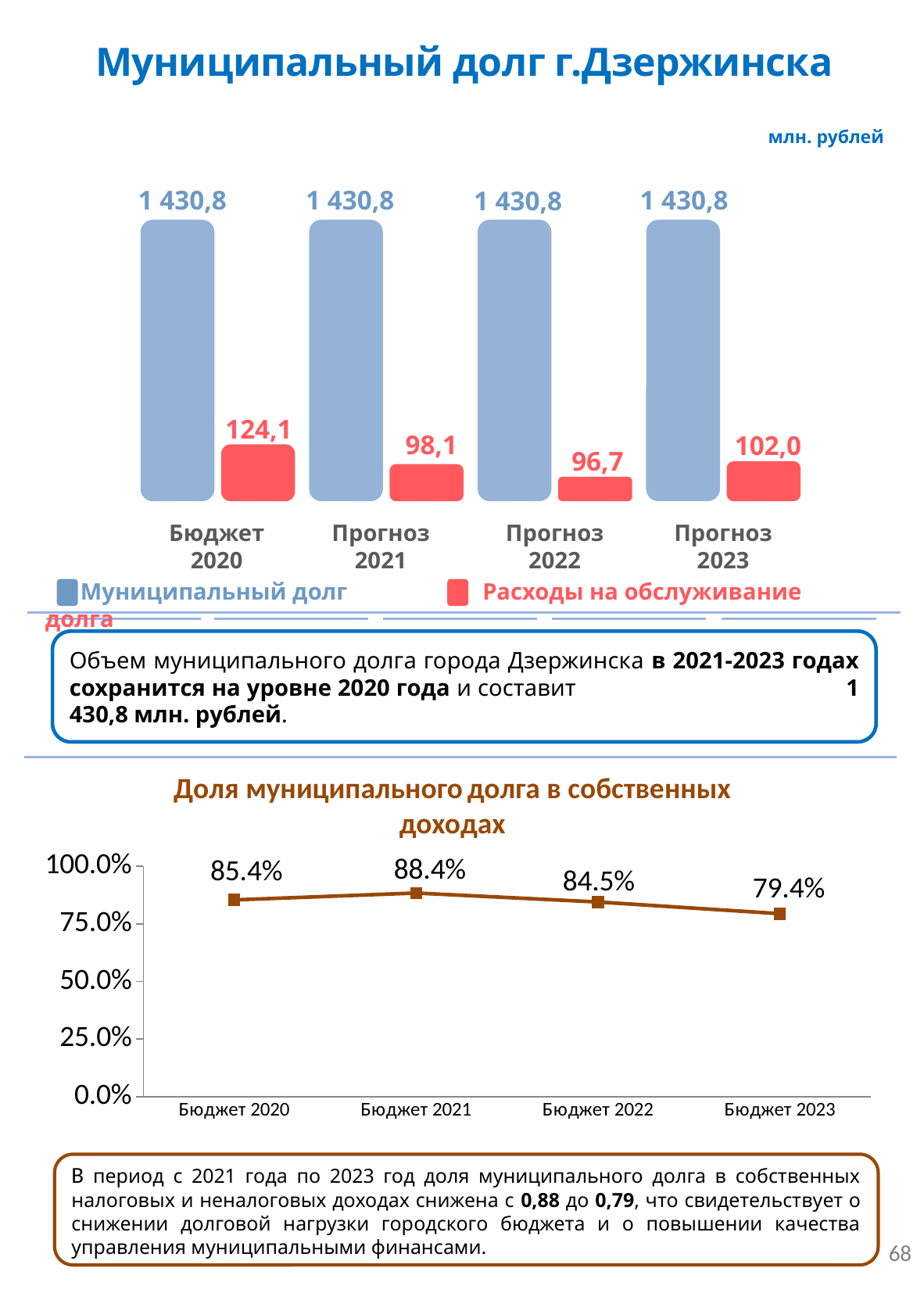
On the top bar chart, what is the value of Расходы на обслуживание долга for Бюджет 2020? 124,1 On the chart 'Доля муниципального долга в собственных доходах', is the value for Бюджет 2023 greater or less than 75.0%? greater On the top bar chart, in which year is Расходы на обслуживание долга lowest? Прогноз 2022 On the chart 'Доля муниципального долга в собственных доходах', which year has the lowest value? Бюджет 2023 On the top bar chart, what is the difference between Расходы на обслуживание долга in Бюджет 2020 and Прогноз 2021? 26,0 On the top bar chart, what unit is shown for the values? млн. рублей What type of chart is the chart titled 'Доля муниципального долга в собственных доходах'? line chart On the top bar chart, what is the value of Муниципальный долг for Прогноз 2023? 1 430,8 On the top bar chart, how many series does the legend list? 2 On the top bar chart, in which year is Расходы на обслуживание долга highest? Бюджет 2020 On the chart 'Доля муниципального долга в собственных доходах', how many data points are plotted? 4 On the chart 'Доля муниципального долга в собственных доходах', what is the value for Бюджет 2021? 88.4%